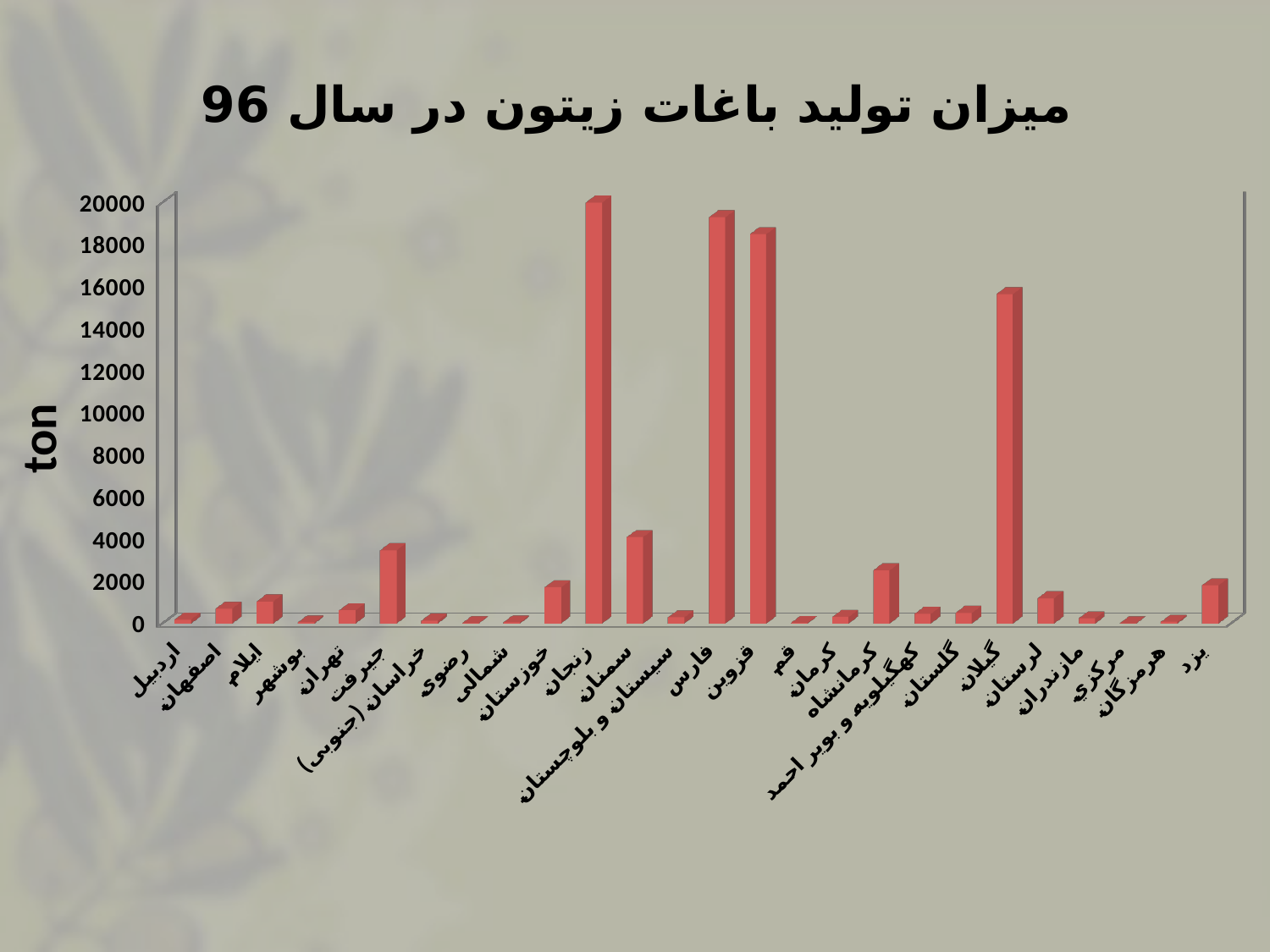
Which is larger, the value for فارس or the value for گیلان? فارس How many provinces (categories) are shown on the x axis? 26 What is the label on the vertical axis? ton Is the value for کرمانشاه greater or less than 4000? less Which province has the highest production? زنجان Is the value for گیلان greater or less than 14000? greater What is the title of the chart? میزان تولید باغات زیتون در سال 96 Which is larger, the value for گیلان or the value for کرمانشاه? گیلان Is the value for زنجان greater or less than 18000? greater What kind of chart is shown on the slide? bar chart